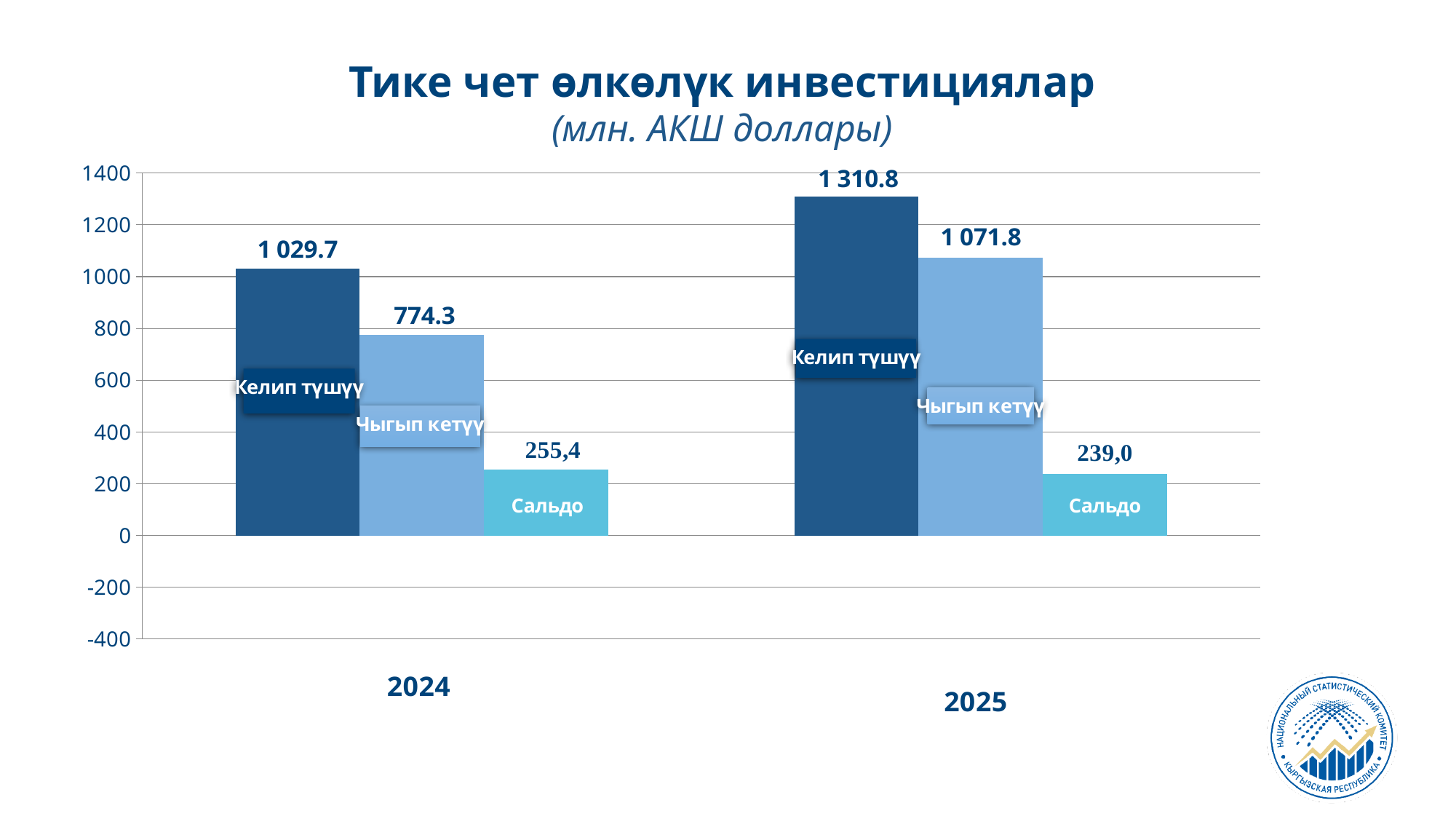
What is the difference between Келип түшүү in 2025 and Келип түшүү in 2024? 281.1 Which year has the higher value for Келип түшүү? 2025 What is the difference between Чыгып кетүү in 2025 and Чыгып кетүү in 2024? 297.5 What is the value of Чыгып кетүү for 2025? 1 071.8 How many years are shown on the x axis? 2 Which year has the higher value for Сальдо? 2024 What unit is given in the chart subtitle? млн. АКШ доллары What is the value of Келип түшүү for 2024? 1 029.7 What is the value of Сальдо for 2024? 255,4 Which bar has the highest value on the chart? Келип түшүү in 2025 What is the value of Сальдо for 2025? 239,0 What type of chart is shown on the slide? Bar chart